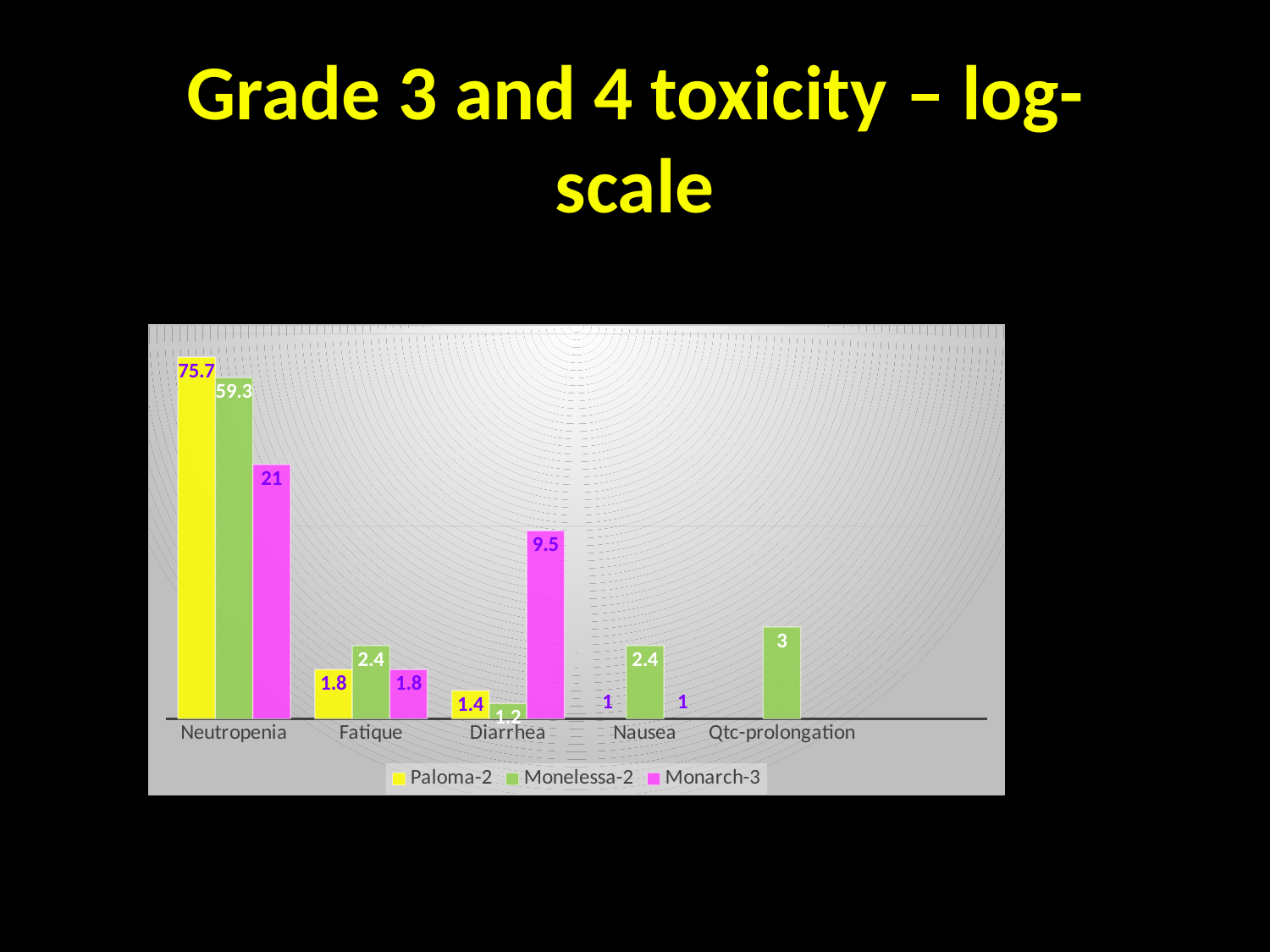
Which is larger for Fatique, the Paloma-2 value or the Monelessa-2 value? Monelessa-2 What is the title of the slide containing the chart? Grade 3 and 4 toxicity – log-scale What is the value for Monarch-3 for Diarrhea? 9.5 What is the value for Monelessa-2 for Qtc-prolongation? 3 What is the difference between the Paloma-2 and Monelessa-2 values for Neutropenia? 16.4 What is the value for Monelessa-2 for Neutropenia? 59.3 What is the value for Paloma-2 for Neutropenia? 75.7 How many series does the legend list? 3 How many categories are shown on the x axis? 5 Which series has the lowest value for Neutropenia? Monarch-3 Which category has the highest value for Monarch-3? Neutropenia What type of chart is shown on the slide? bar chart